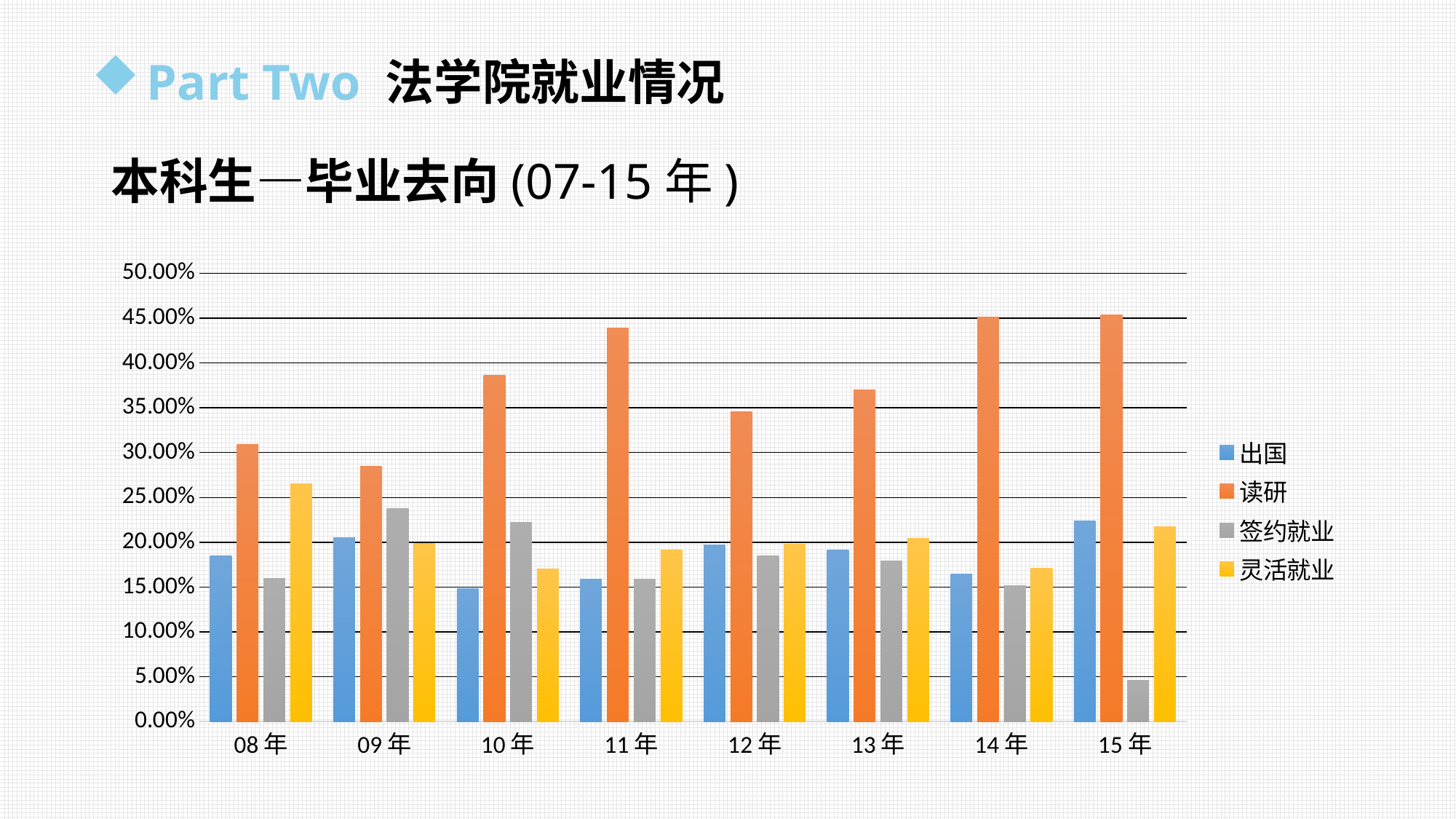
Is the 读研 value for 11 年 greater or less than 40.00%? greater In which year is the 签约就业 value lowest? 15 年 How many series does the legend list? 4 How many year categories are shown on the x axis? 8 In which year is the 灵活就业 value highest? 08 年 In which year is the 出国 value highest? 15 年 What kind of chart is shown on the slide? bar chart Does the 读研 value rise or fall from 12 年 to 15 年? rise Which series has the highest value in every year shown? 读研 In which year is the 读研 value lowest? 09 年 In 09 年, which is larger: 签约就业 or 出国? 签约就业 Is the 签约就业 value for 15 年 greater or less than 5.00%? less